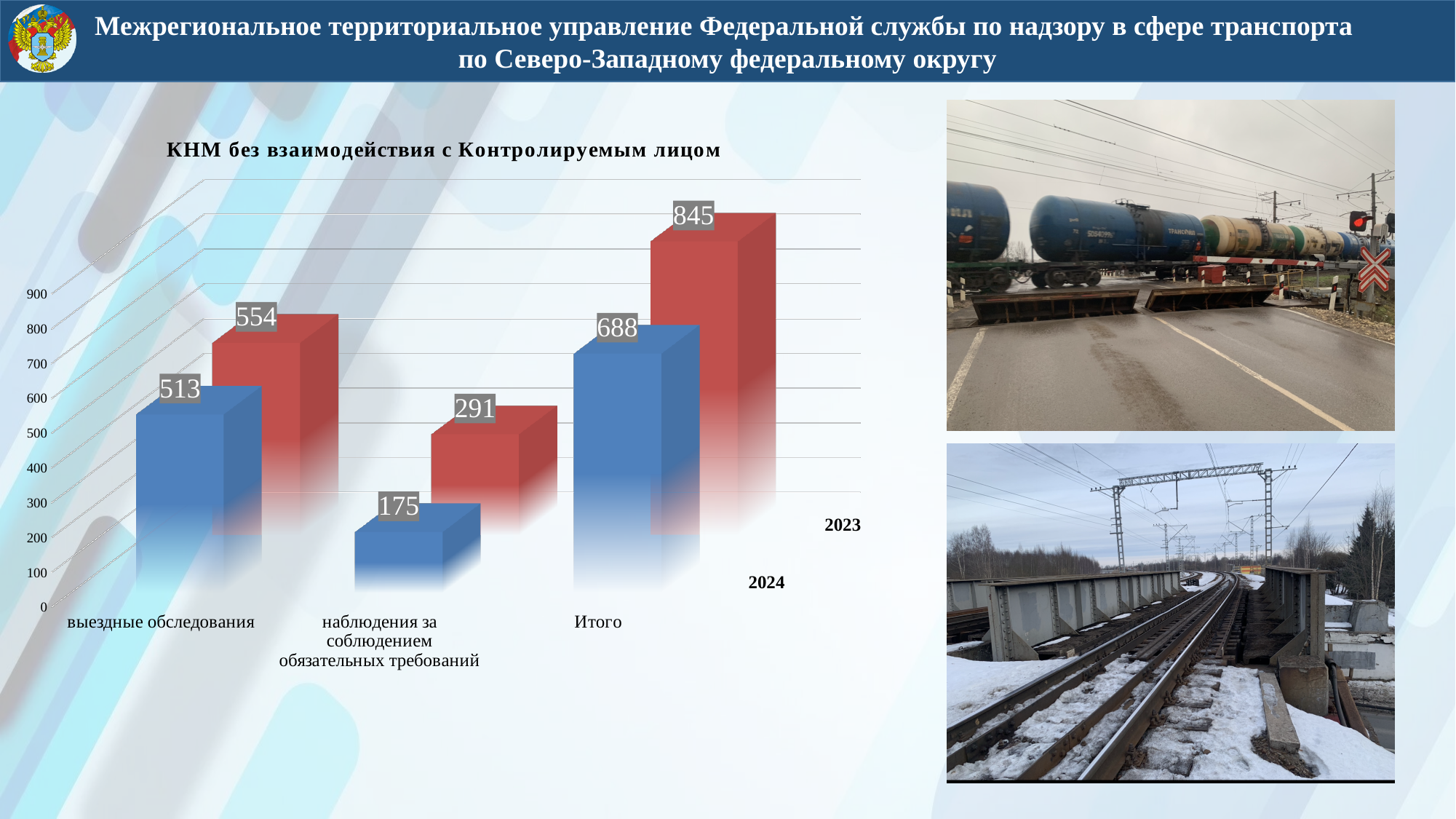
What is the value for выездные обследования in 2024? 513 How many series (years) does the chart show? 2 What is the value for наблюдения за соблюдением обязательных требований in 2023? 291 Which category has the lowest value in 2024? наблюдения за соблюдением обязательных требований What is the Итого value for 2024? 688 How many categories are shown on the x axis? 3 What is the difference between the Итого values for 2023 and 2024? 157 What is the Итого value for 2023? 845 Which is larger for наблюдения за соблюдением обязательных требований: the 2023 value or the 2024 value? 2023 What is the difference between the 2023 and 2024 values for выездные обследования? 41 What kind of chart is shown on the slide? bar chart What is the title of the chart? КНМ без взаимодействия с Контролируемым лицом